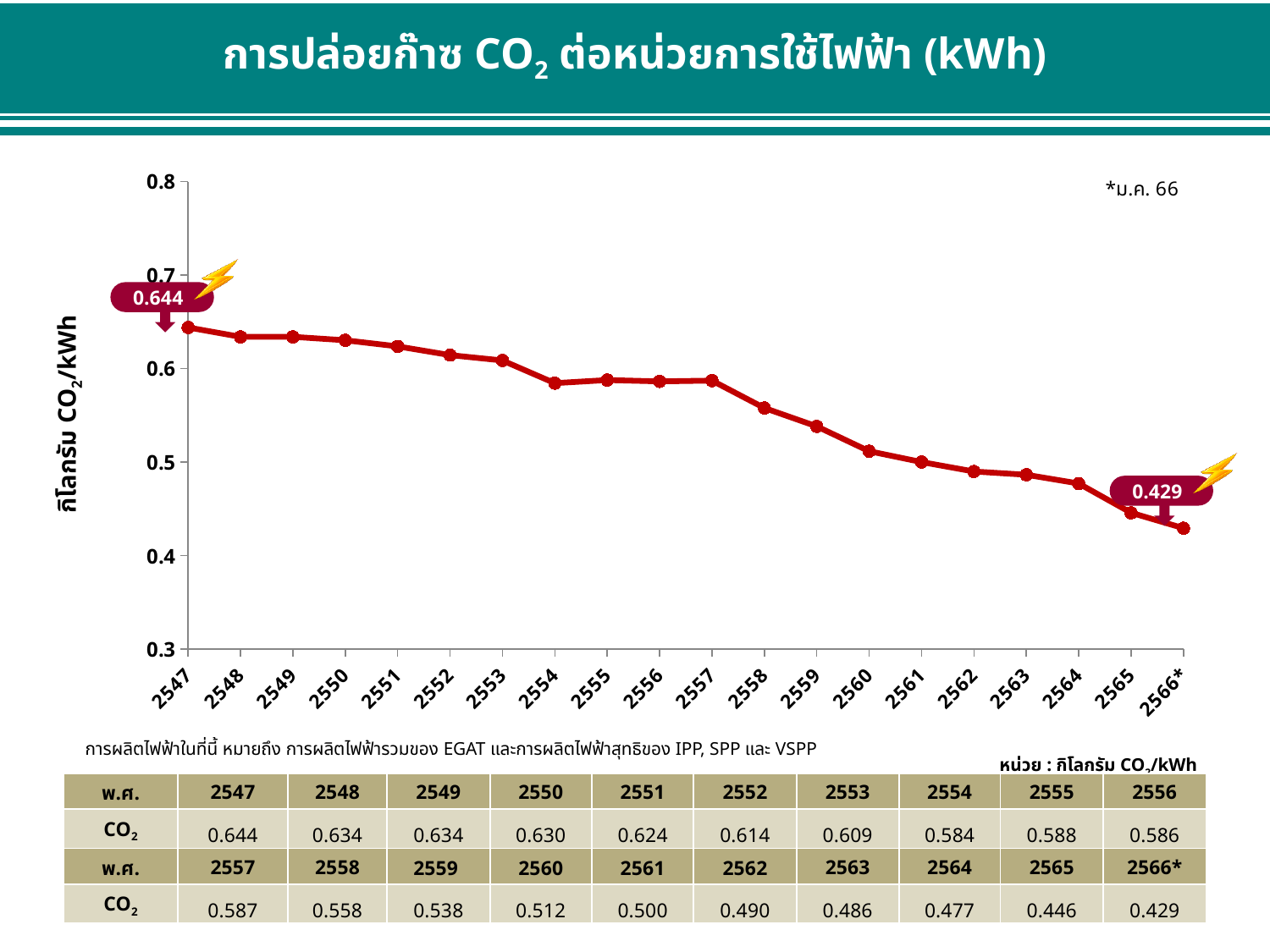
What is the CO2 emission value for the year 2558? 0.558 What is the difference between the CO2 emission values for 2547 and 2566*? 0.215 Which year has a higher CO2 emission value, 2558 or 2560? 2558 How many years (data points) are plotted on the chart? 20 Do the CO2 emission values generally rise or fall from 2547 to 2566*? fall What is the CO2 emission value for the year 2547? 0.644 Is the value for 2565 greater or less than 0.5? less What is the CO2 emission value for the year 2566*? 0.429 What is the CO2 emission value for the year 2561? 0.500 Which year has the lowest CO2 emission per kWh? 2566* What type of chart is shown on the slide? line chart Which year has the highest CO2 emission per kWh? 2547